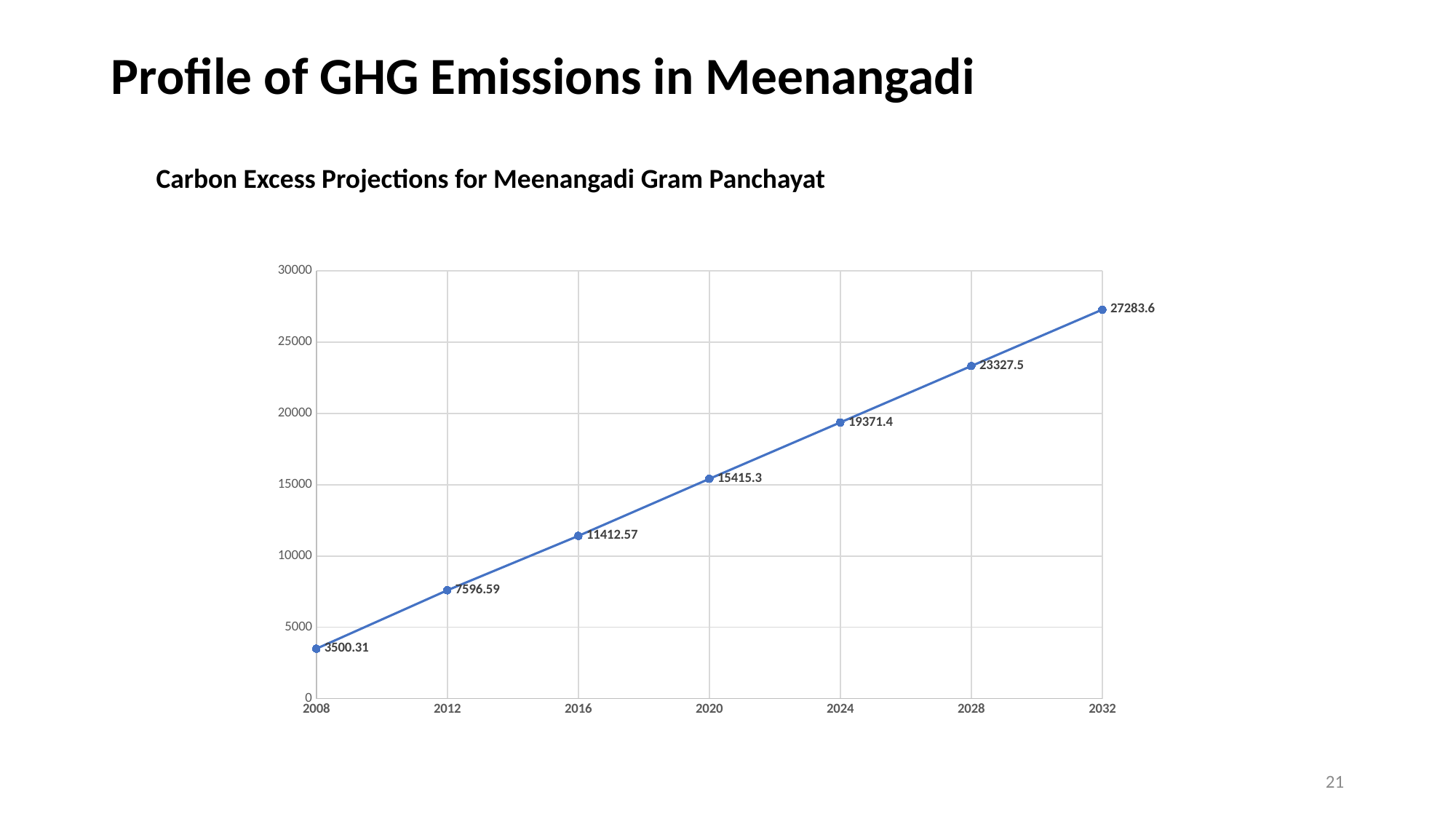
What is the difference between the values for 2032 and 2028? 3956.1 What kind of chart is shown on the slide? line chart Which year has the lowest value? 2008 What is the value for 2008? 3500.31 Is the value for 2028 greater or less than 20000? greater Do the values rise or fall from 2008 to 2032? rise What is the value for 2024? 19371.4 What is the value for 2016? 11412.57 How many data points are plotted on the chart? 7 Which year has the highest value? 2032 Which is larger, the value for 2020 or the value for 2012? 2020 What is the value for 2032? 27283.6